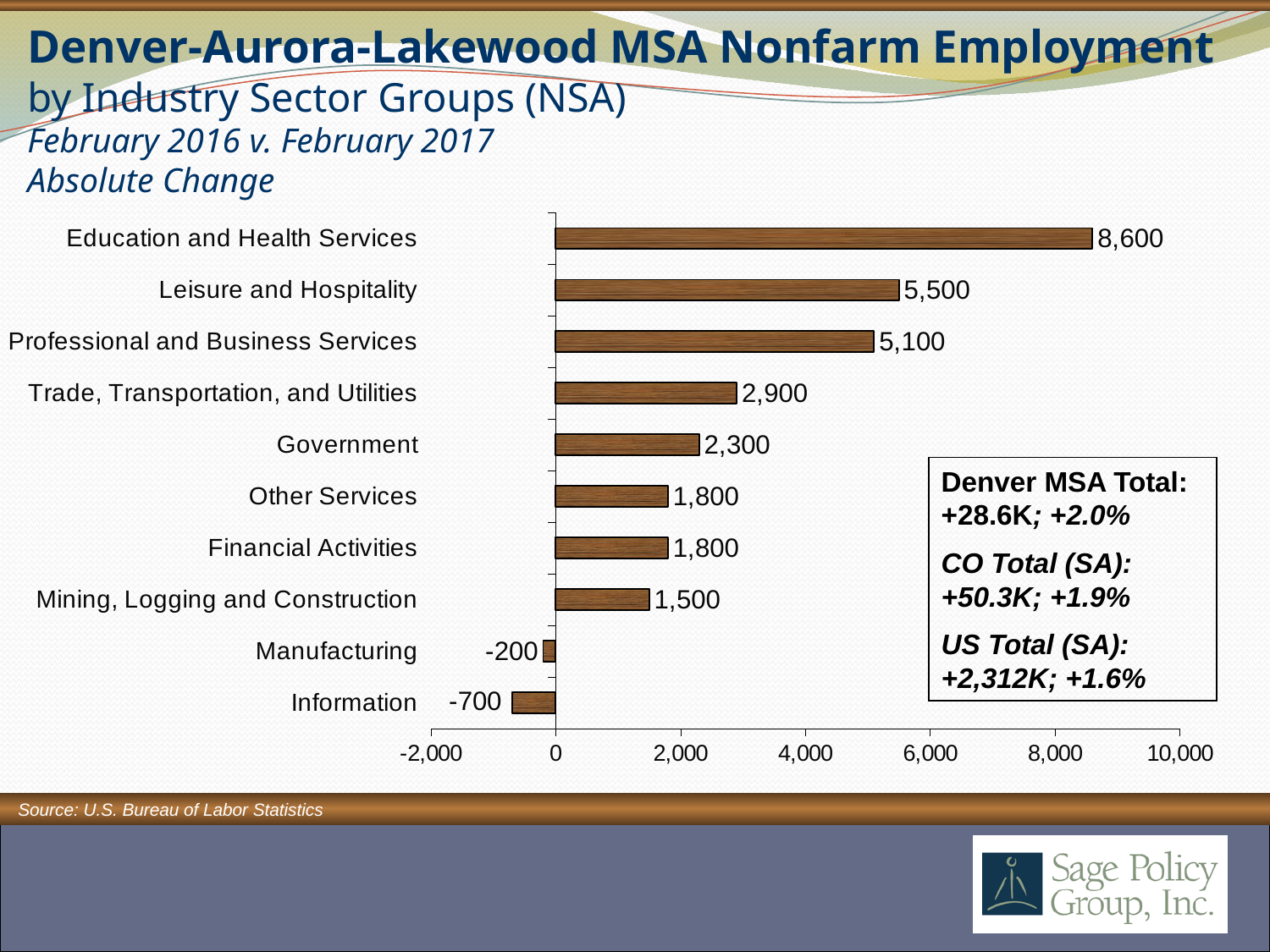
How many industry sector groups are shown in the chart? 10 What is the difference between the absolute change for Leisure and Hospitality and Professional and Business Services? 400 What kind of chart is shown on the slide? Bar chart What is the absolute change in employment for Government? 2,300 What is the absolute change in employment for Information? -700 Which industry sector group has the largest absolute change? Education and Health Services According to the text box on the chart, what is the Denver MSA total change? +28.6K; +2.0% How many industry sector groups show a negative absolute change? 2 What is the difference between the absolute change for Education and Health Services and Mining, Logging and Construction? 7,100 Which industry sector group has the smallest absolute change? Information What is the absolute change in employment for Education and Health Services? 8,600 Which has a larger absolute change, Trade, Transportation, and Utilities or Government? Trade, Transportation, and Utilities